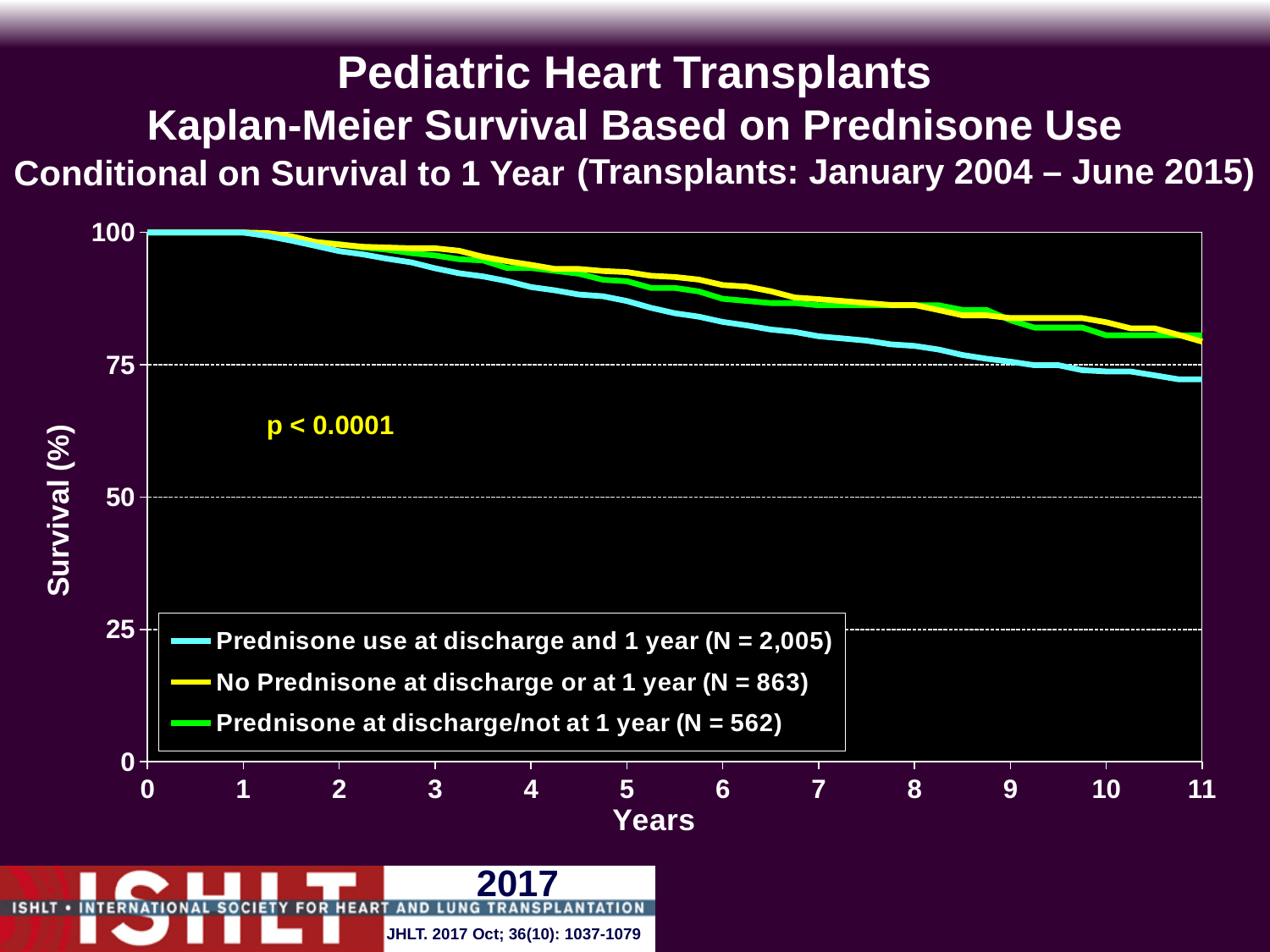
What p-value is printed on the chart? p < 0.0001 What kind of chart is shown on the slide? line chart What is the N for the 'Prednisone at discharge/not at 1 year' group? 562 At 11 years, is survival for 'No Prednisone at discharge or at 1 year' greater or less than 75? greater At 11 years, which series has higher survival: 'No Prednisone at discharge or at 1 year' or 'Prednisone use at discharge and 1 year'? No Prednisone at discharge or at 1 year Do the survival curves rise or fall as years increase? fall Which series has the lowest survival at 11 years? Prednisone use at discharge and 1 year (N = 2,005) How many series does the legend list? 3 At 5 years, is survival for 'Prednisone use at discharge and 1 year' greater or less than 75? greater At 11 years, is survival for 'Prednisone use at discharge and 1 year' greater or less than 75? less What is the maximum value shown on the x axis (Years)? 11